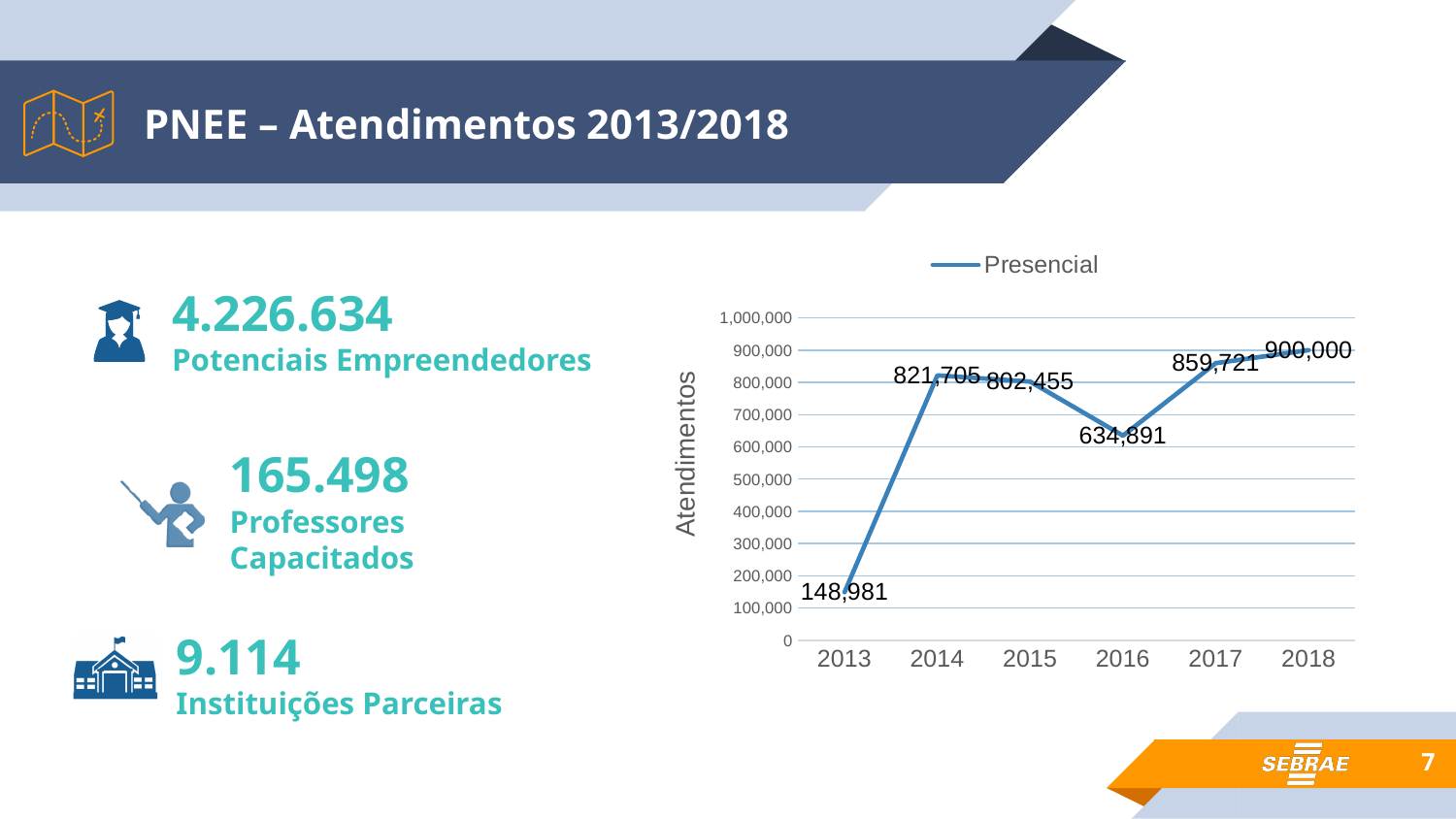
What is the value for 2016? 634,891 What is the value for 2013? 148,981 Which year has the highest value? 2018 What is the difference between the values for 2014 and 2015? 19,250 Which year has the lowest value? 2013 How many years are plotted on the x axis? 6 What is the label on the y axis? Atendimentos How many series does the legend list? 1 What is the value for 2018? 900,000 Which is larger, the value for 2017 or the value for 2016? 2017 What is the difference between the values for 2018 and 2013? 751,019 What type of chart is shown on the slide? Line chart